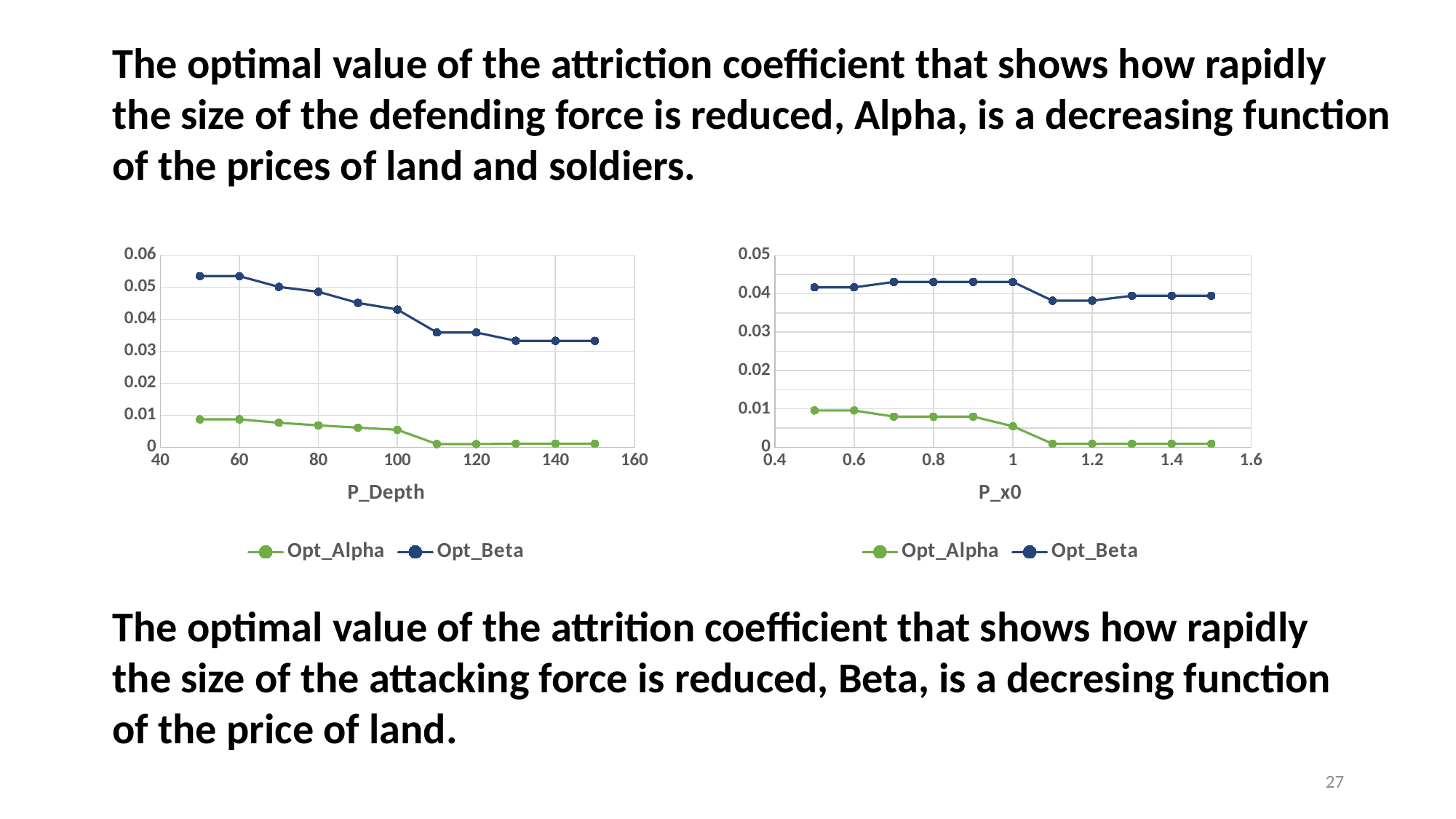
In the right chart (x-axis P_x0), how many data points does the Opt_Alpha series have? 11 In the right chart (x-axis P_x0), does the Opt_Alpha series generally rise or fall as P_x0 increases? fall In the left chart (x-axis P_Depth), is the Opt_Beta value at P_Depth 150 greater or less than 0.04? less What type of chart is the left chart with x-axis P_Depth? line chart In the left chart (x-axis P_Depth), how many data points does the Opt_Beta series have? 11 In the left chart (x-axis P_Depth), is the Opt_Beta value larger at P_Depth 50 or at P_Depth 150? P_Depth 50 In the right chart (x-axis P_x0), which series has the larger value at P_x0 1.0, Opt_Alpha or Opt_Beta? Opt_Beta What is the x-axis title of the right chart? P_x0 In the left chart (x-axis P_Depth), does the Opt_Beta series generally rise or fall as P_Depth increases? fall How many series does the legend of the right chart (x-axis P_x0) list? 2 In the right chart (x-axis P_x0), is the Opt_Beta value at P_x0 0.8 greater or less than 0.04? greater